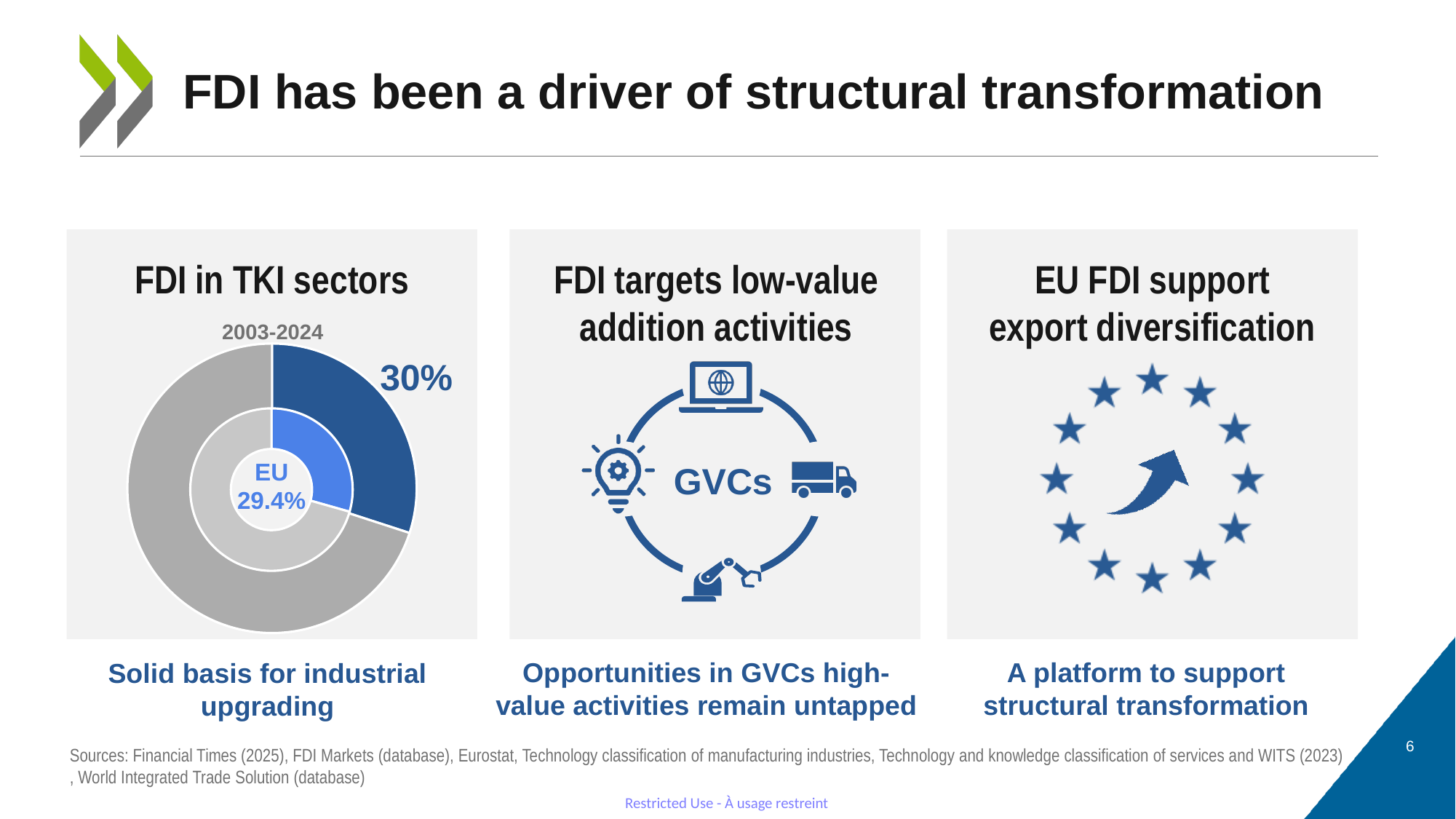
In the 'FDI in TKI sectors' chart, what is the difference between the outer-ring share (30%) and the EU share (29.4%)? 0.6 percentage points What time period is labelled above the 'FDI in TKI sectors' chart? 2003-2024 In the 'FDI in TKI sectors' chart, is the EU share greater or less than 50%? less In the 'FDI in TKI sectors' chart, what colour is the slice labelled 30%? Blue How many rings does the 'FDI in TKI sectors' doughnut chart have? 2 In the 'FDI in TKI sectors' chart, what value is shown for the EU in the inner ring? 29.4% What is the title of the chart on the left of the slide? FDI in TKI sectors In the 'FDI in TKI sectors' chart, which is larger: the outer-ring share of 30% or the EU share of 29.4%? 30% What kind of chart is shown in the 'FDI in TKI sectors' panel? Doughnut chart In the 'FDI in TKI sectors' chart, what share is shown for the blue slice of the outer ring? 30%